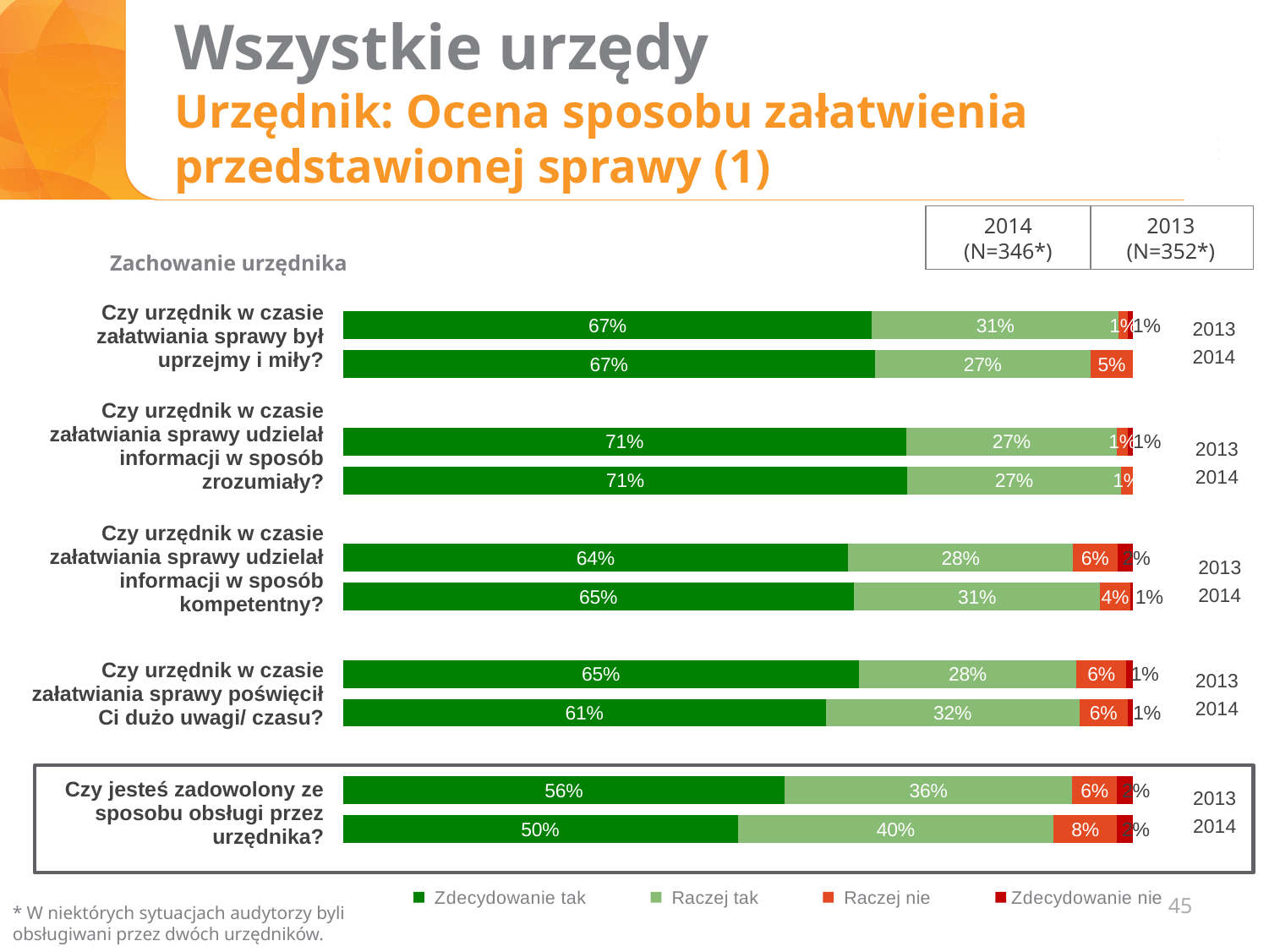
Which question has the highest 'Zdecydowanie tak' value in 2013? Czy urzędnik w czasie załatwiania sprawy udzielał informacji w sposób zrozumiały? What is the 'Raczej tak' value for 2013 for the question 'Czy jesteś zadowolony ze sposobu obsługi przez urzędnika?' 36% What is the 'Raczej nie' value for 2014 for the question 'Czy urzędnik w czasie załatwiania sprawy był uprzejmy i miły?' 5% Which question has the lowest 'Zdecydowanie tak' value in 2014? Czy jesteś zadowolony ze sposobu obsługi przez urzędnika? How many series does the legend list? 4 What is the sample size (N) shown for 2014? N=346* What is the 'Zdecydowanie tak' value for 2014 for the question 'Czy urzędnik w czasie załatwiania sprawy poświęcił Ci dużo uwagi/ czasu?' 61% What is the 'Zdecydowanie tak' value for 2014 for the question 'Czy jesteś zadowolony ze sposobu obsługi przez urzędnika?' 50% For the question 'Czy urzędnik w czasie załatwiania sprawy udzielał informacji w sposób kompetentny?', is the 'Raczej tak' value larger in 2013 or 2014? 2014 What type of chart is shown on the slide? stacked bar chart What is the 'Raczej nie' value for 2014 for the question 'Czy jesteś zadowolony ze sposobu obsługi przez urzędnika?' 8% What is the difference between the 2013 and 2014 'Zdecydowanie tak' values for the question 'Czy jesteś zadowolony ze sposobu obsługi przez urzędnika?' 6%